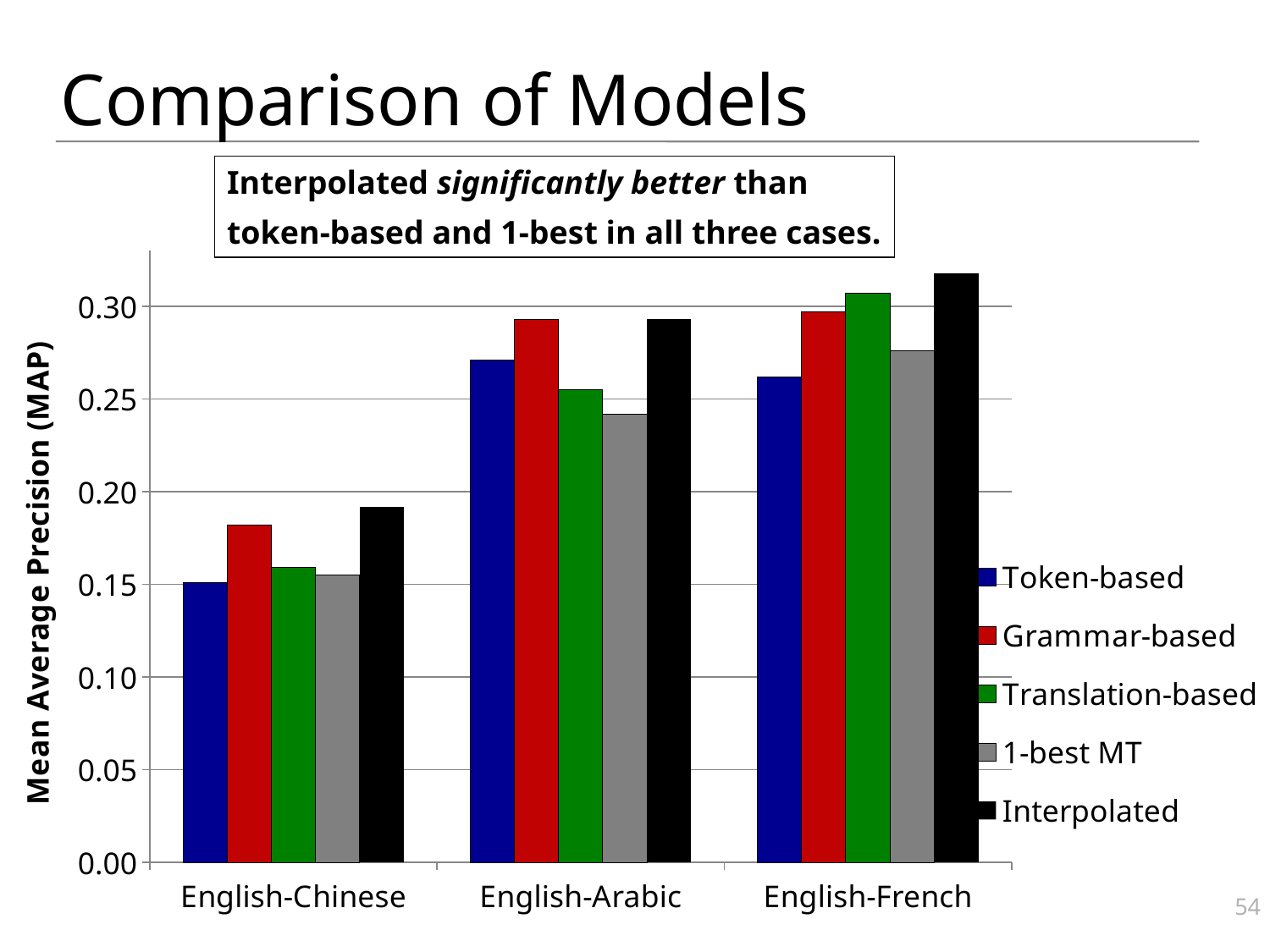
Within English-French, which model has the highest bar? Interpolated Is the Interpolated value for English-French greater or less than 0.30? greater Within English-Arabic, which model has the lowest bar? 1-best MT For which language pair is the Token-based bar lowest? English-Chinese For which language pair is the Interpolated bar highest? English-French What is the label of the y axis? Mean Average Precision (MAP) How many series does the legend list? 5 What kind of chart is shown on the slide? bar chart How many language pairs are shown on the x axis? 3 Is the Grammar-based value for English-Chinese greater or less than 0.20? less What colour are the Interpolated bars? black For English-Arabic, which is larger: the Grammar-based bar or the Translation-based bar? Grammar-based